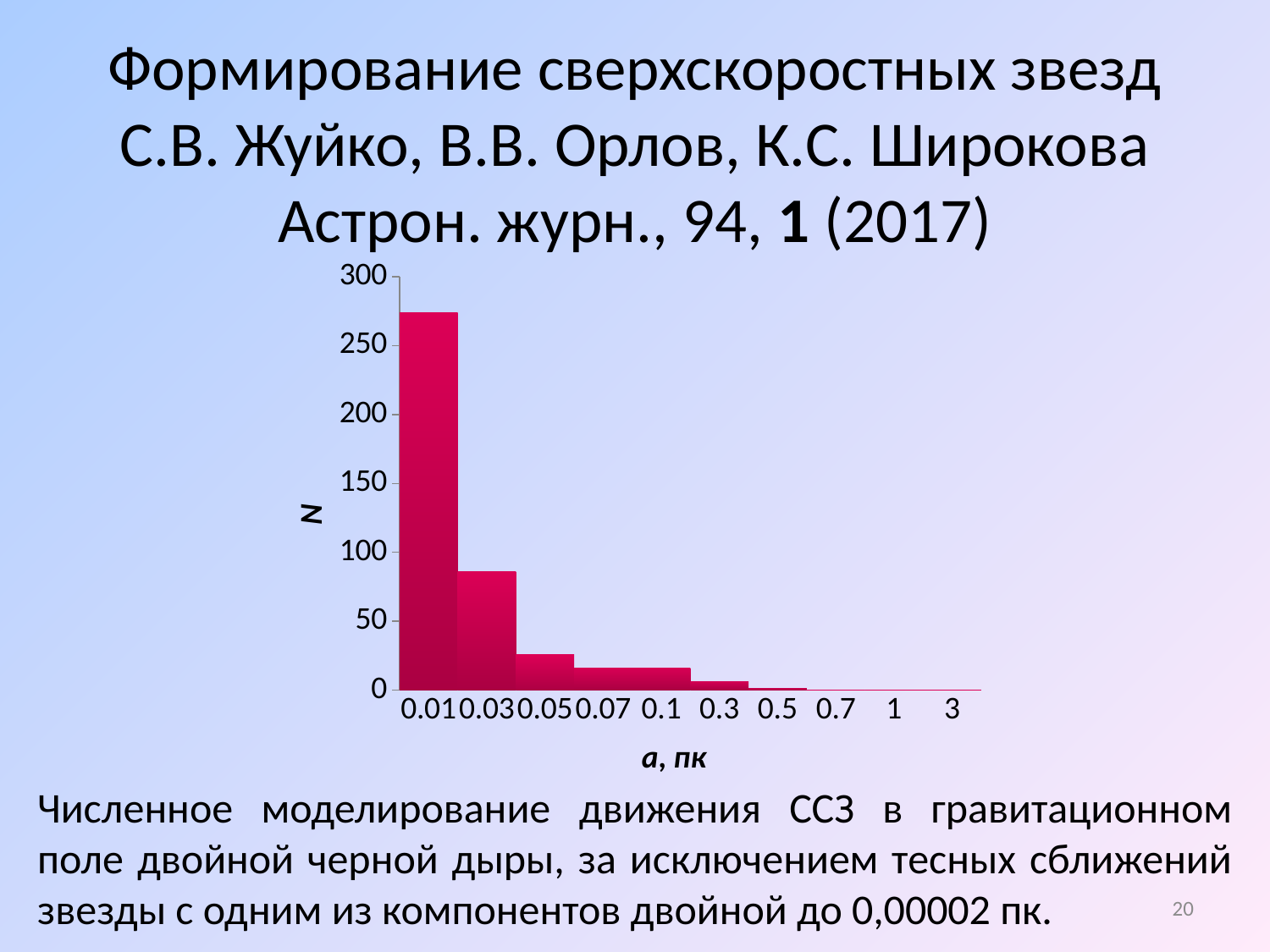
Is the value of N for the category 0.03 greater or less than 50? greater What is the label of the x axis of the chart? a, пк Which has a larger value of N: the category 0.01 or the category 0.03? 0.01 Do the values of N generally rise or fall as a increases along the x axis? fall How many categories are shown along the x axis of the chart? 10 Is the value of N for the category 0.05 greater or less than 50? less Which category on the x axis has the highest value of N? 0.01 Is the value of N for the category 0.03 greater or less than 100? less Which has a larger value of N: the category 0.05 or the category 0.3? 0.05 What kind of chart is shown on the slide? bar chart What is the label of the y axis of the chart? N